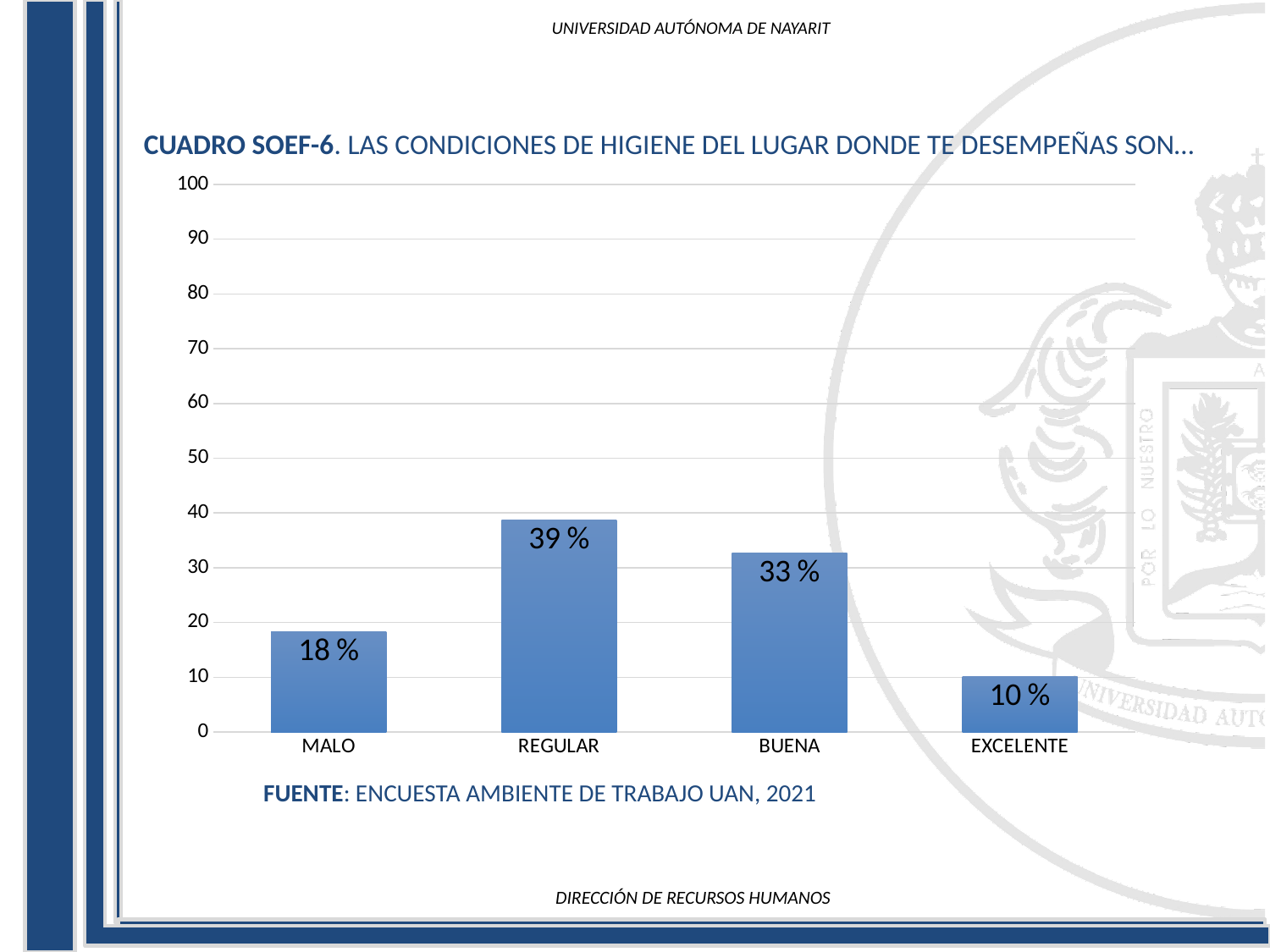
What is the value for REGULAR? 39 % What is the value for EXCELENTE? 10 % Which is larger, the value for MALO or the value for BUENA? BUENA What is the difference between the values for REGULAR and BUENA? 6 % Is the value for BUENA greater or less than 40? less What source is cited below the chart? ENCUESTA AMBIENTE DE TRABAJO UAN, 2021 What is the maximum value shown on the y axis? 100 Which category has the highest value? REGULAR What kind of chart is shown on the slide? bar chart What is the value for MALO? 18 % Which category has the lowest value? EXCELENTE How many categories are shown on the x axis? 4